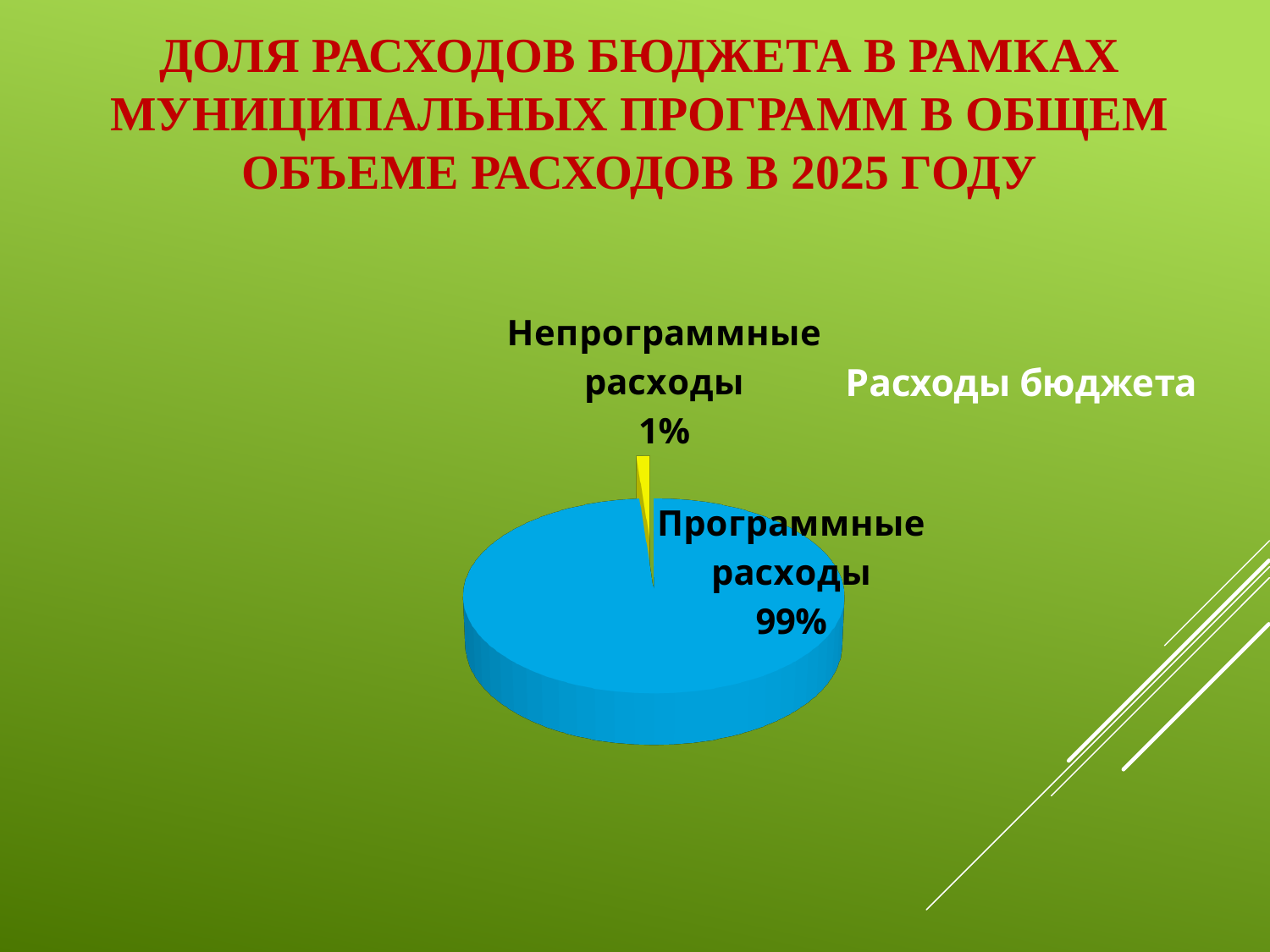
What share of the pie does "Программные расходы" represent? 99% Which slice of the pie is the largest? Программные расходы Which slice of the pie is the smallest? Непрограммные расходы What kind of chart is shown on the slide? Pie chart What is the title of the chart? Расходы бюджета Which is larger: "Программные расходы" or "Непрограммные расходы"? Программные расходы What share of the pie does "Непрограммные расходы" represent? 1% What is the difference in percentage points between "Программные расходы" and "Непрограммные расходы"? 98 How many slices does the pie chart have? 2 What colour is the "Непрограммные расходы" slice? Yellow